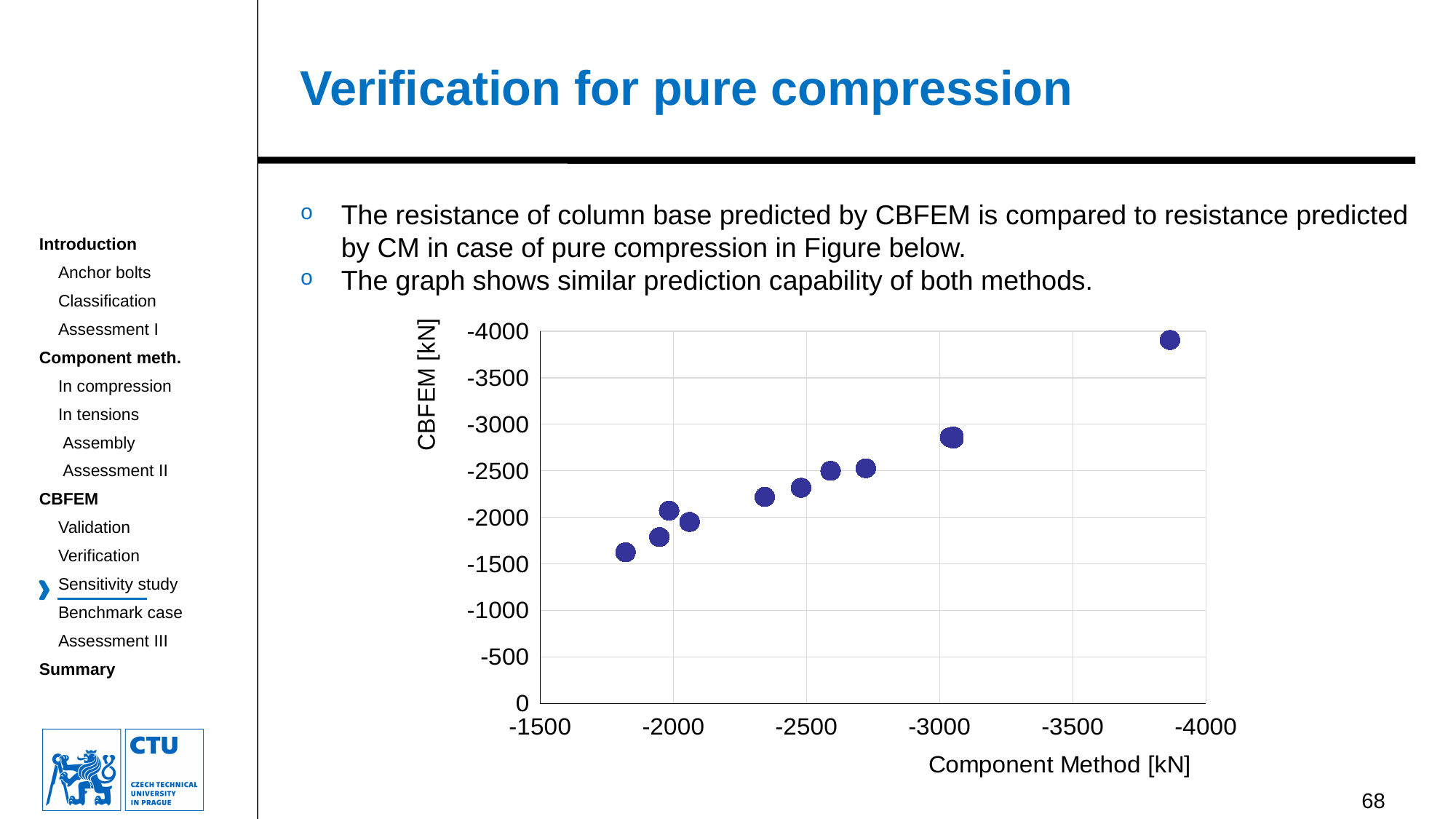
As the Component Method values move from -1500 toward -4000 along the x axis, do the CBFEM values move toward 0 or toward -4000? Toward -4000 Is the CBFEM value of the point with the Component Method value nearest -4000 greater or less than -3500? less Is the Component Method value of the point with the CBFEM value nearest -4000 greater or less than -3500? less What is the label of the x axis of the chart? Component Method [kN] What kind of chart is shown on the slide? Scatter chart What is the label of the y axis of the chart? CBFEM [kN] Is the CBFEM value of the point with the Component Method value nearest -1500 greater or less than -2000? greater